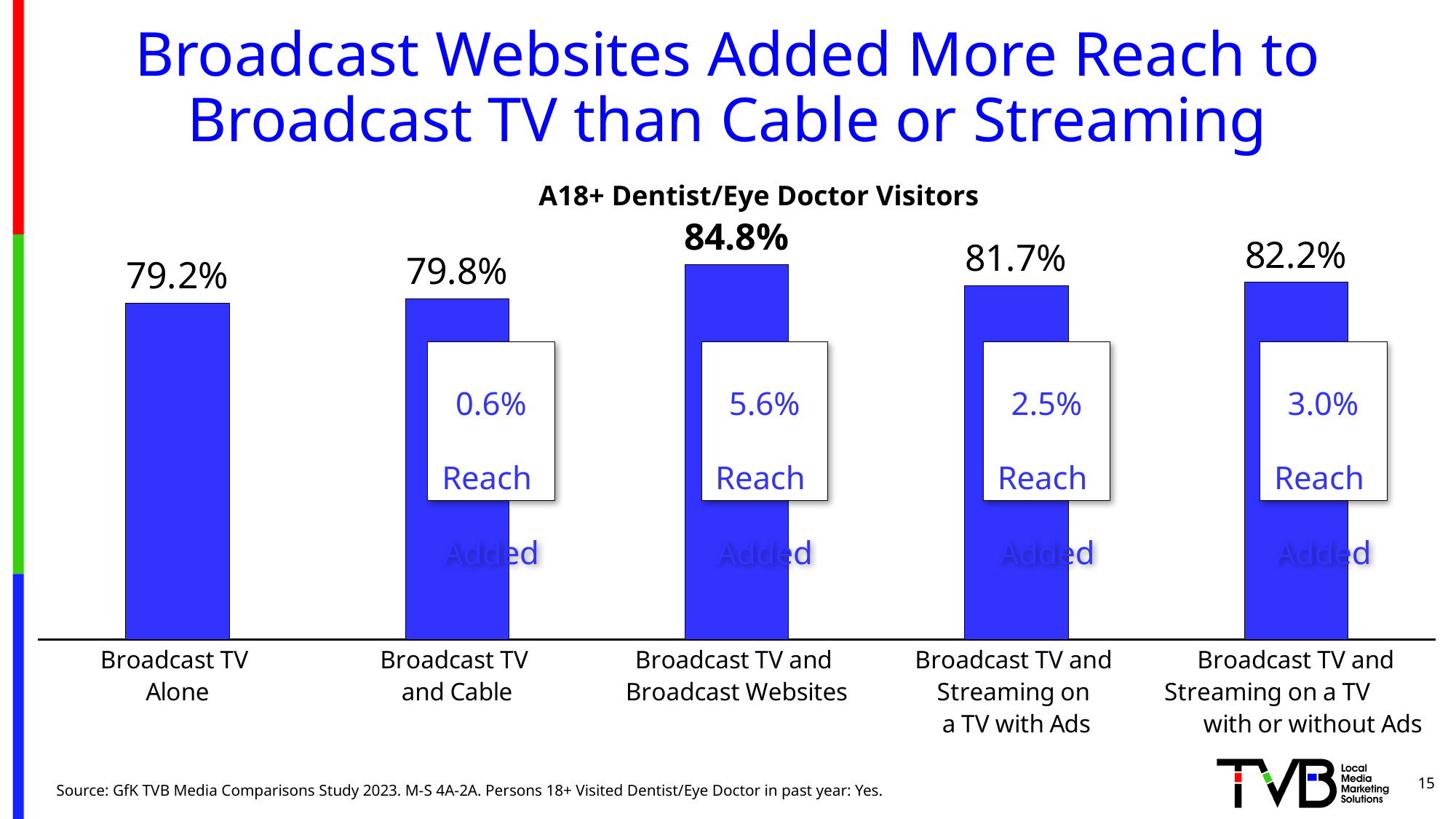
How many categories are shown in the chart? 5 Which category has the lowest reach? Broadcast TV Alone What kind of chart is shown on the slide? Bar chart What is the reach value for Broadcast TV Alone? 79.2% What is the difference in reach between Broadcast TV and Broadcast Websites and Broadcast TV Alone? 5.6% What is the reach value for Broadcast TV and Streaming on a TV with Ads? 81.7% What is the reach value for Broadcast TV and Cable? 79.8% What is the title of the chart? A18+ Dentist/Eye Doctor Visitors Which has a larger reach: Broadcast TV and Cable or Broadcast TV and Streaming on a TV with or without Ads? Broadcast TV and Streaming on a TV with or without Ads How much reach was added by Broadcast Websites according to the label on the bar? 5.6% What is the reach value for Broadcast TV and Broadcast Websites? 84.8% Which category has the highest reach? Broadcast TV and Broadcast Websites